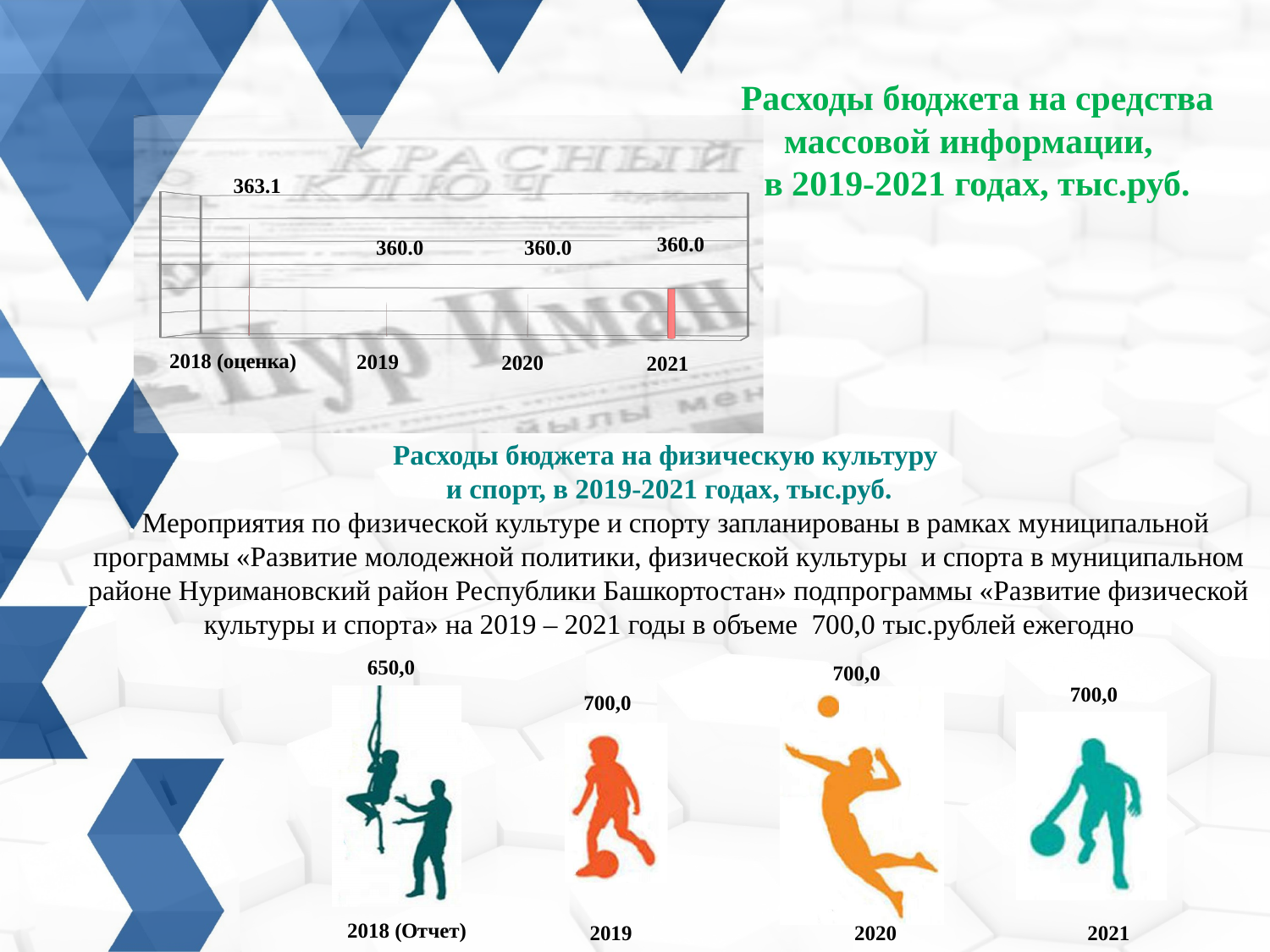
In the lower infographic 'Расходы бюджета на физическую культуру и спорт', which year has the lowest value? 2018 (Отчет) In the chart 'Расходы бюджета на средства массовой информации', which category has the highest value? 2018 (оценка) In the chart 'Расходы бюджета на средства массовой информации', what is the value for 2019? 360.0 How many categories are shown in the chart 'Расходы бюджета на средства массовой информации'? 4 In the chart 'Расходы бюджета на средства массовой информации', what is the value for 2018 (оценка)? 363.1 In the chart 'Расходы бюджета на средства массовой информации', what is the difference between the values for 2018 (оценка) and 2020? 3.1 In the lower infographic 'Расходы бюджета на физическую культуру и спорт', what is the value for 2018 (Отчет)? 650,0 In the lower infographic 'Расходы бюджета на физическую культуру и спорт', what is the difference between the values for 2019 and 2018 (Отчет)? 50,0 In the chart 'Расходы бюджета на средства массовой информации', which is larger, the value for 2018 (оценка) or the value for 2019? 2018 (оценка) What kind of chart is 'Расходы бюджета на средства массовой информации'? bar chart In the chart 'Расходы бюджета на средства массовой информации', what is the value for 2021? 360.0 In the chart 'Расходы бюджета на средства массовой информации', how do the values change from 2019 to 2021? They stay the same